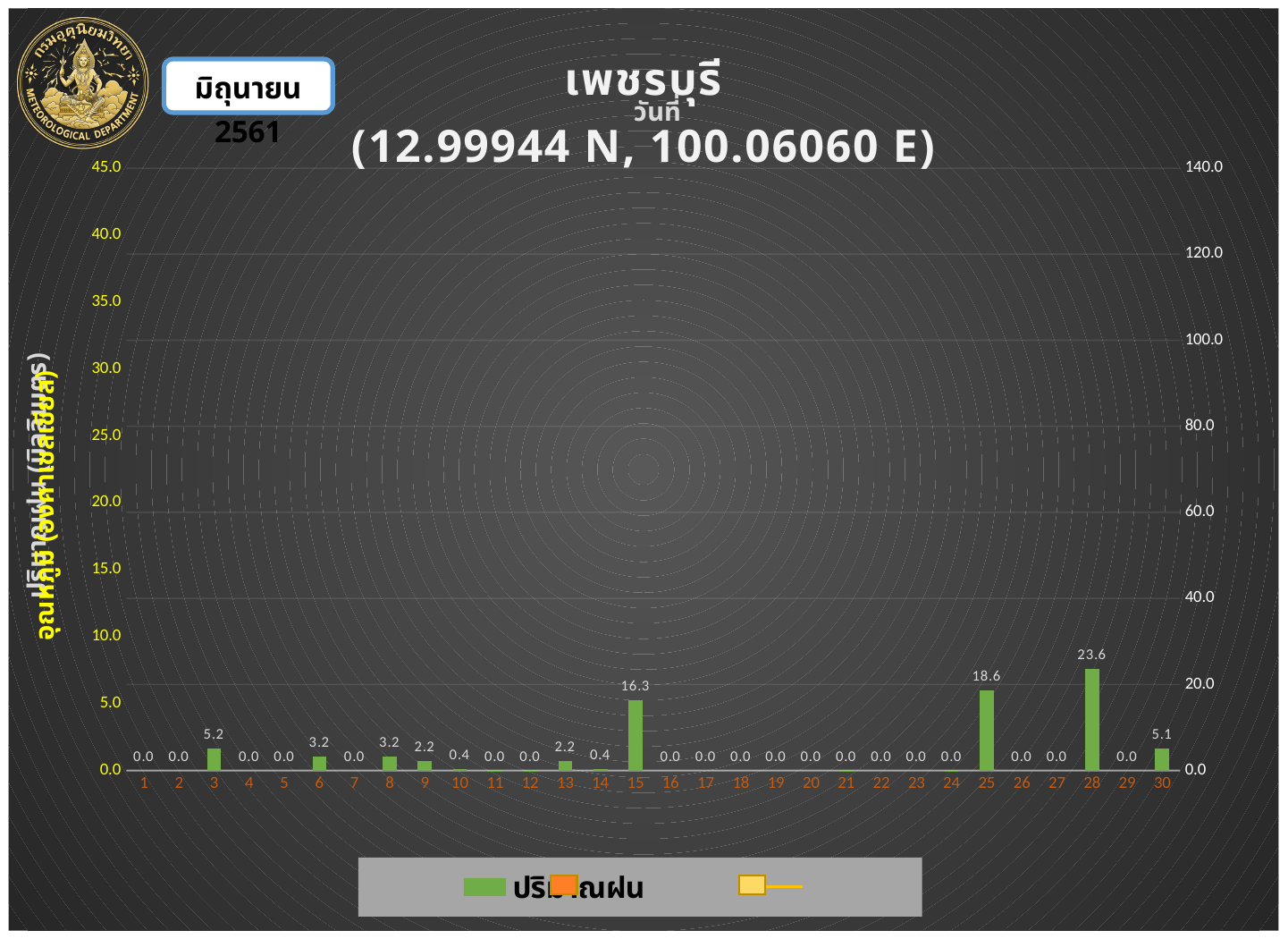
What is the difference between the rainfall values for day 28 and day 25? 5.0 What is the rainfall value shown for day 30? 5.1 Which day has the highest rainfall value? 28 How many days are shown on the x axis? 30 What is the rainfall value shown for day 3? 5.2 What is the rainfall value shown for day 15? 16.3 Which is larger, the rainfall value for day 15 or for day 25? day 25 What is the difference between the rainfall values for day 3 and day 6? 2.0 What is the rainfall value shown for day 25? 18.6 What is the rainfall value shown for day 28? 23.6 What kind of chart is used to show the rainfall values? bar chart What are the coordinates shown in the chart title? 12.99944 N, 100.06060 E